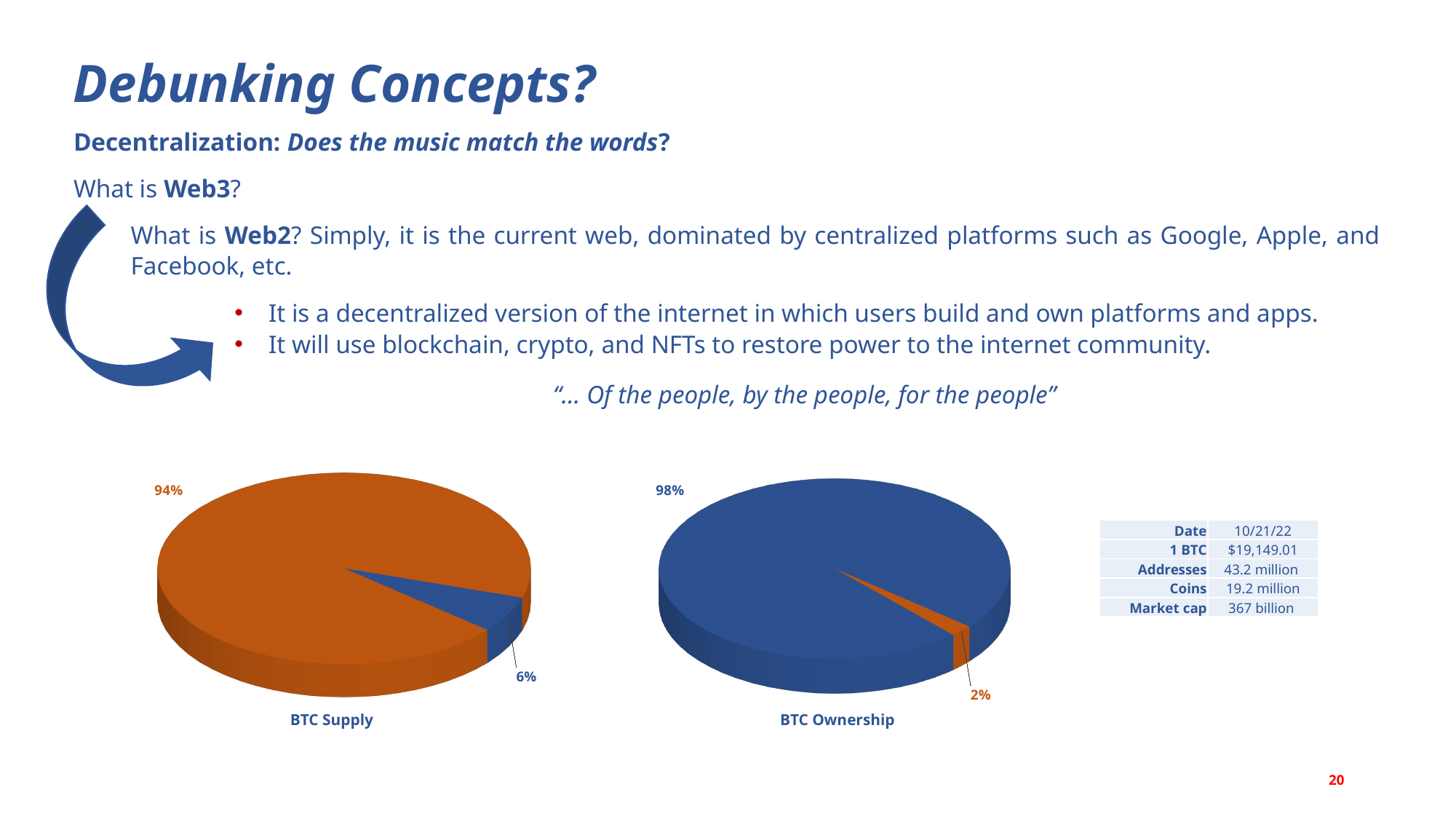
What is the title of the pie chart on the left? BTC Supply What kind of chart is the BTC Supply chart? pie chart In the BTC Ownership chart, what share does the blue slice have? 98% What kind of chart is the BTC Ownership chart? pie chart In the BTC Ownership chart, which slice is larger, the blue one or the orange one? the blue one In the BTC Ownership chart, what share does the orange slice have? 2% In the BTC Supply chart, what is the difference between the larger and smaller slice? 88% How many slices does the BTC Supply pie chart have? 2 In the BTC Supply chart, what share does the blue slice have? 6% In the BTC Ownership chart, what is the difference between the larger and smaller slice? 96% How many slices does the BTC Ownership pie chart have? 2